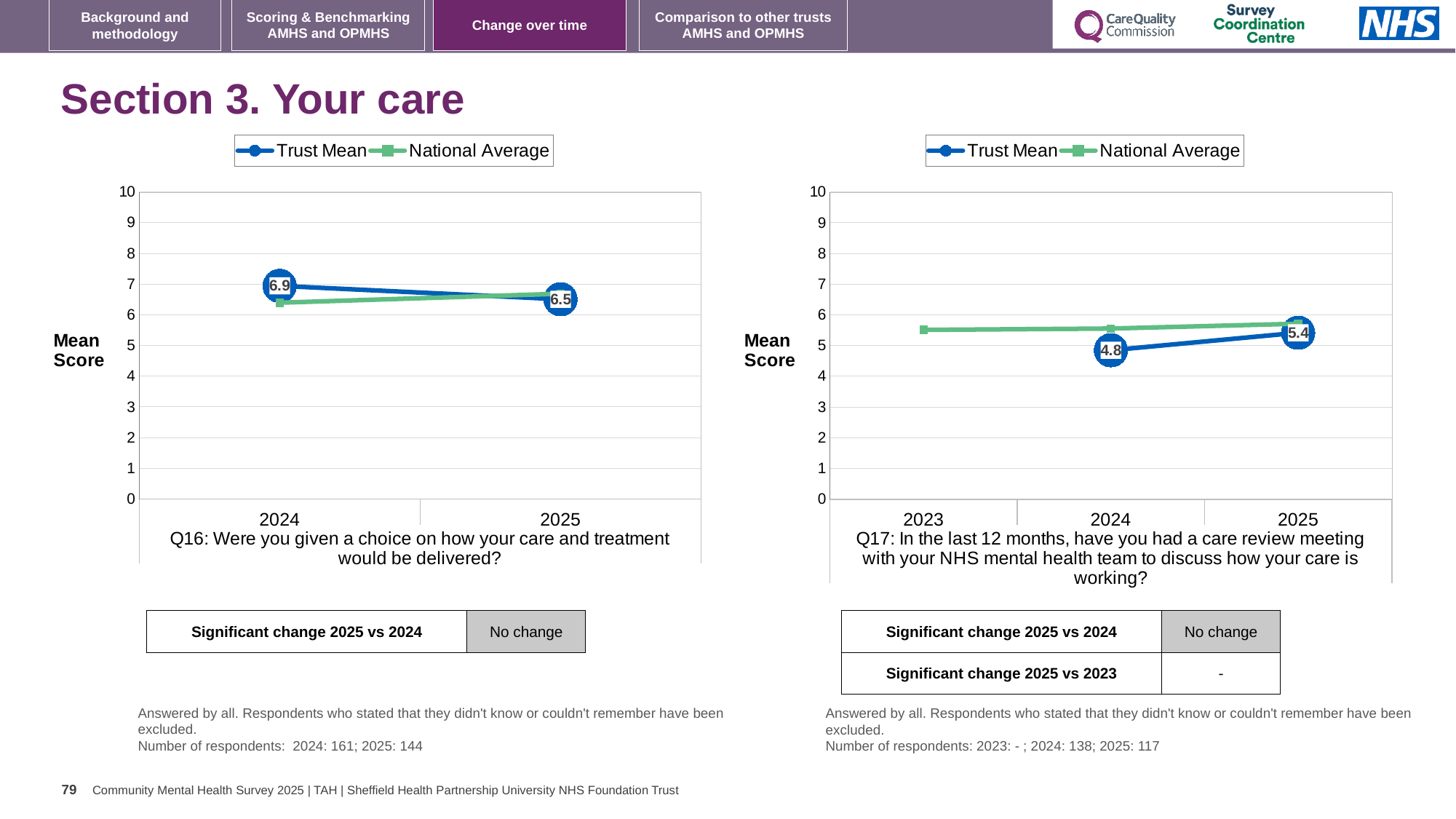
On the Q16 chart (left), by how much did the Trust Mean change from 2024 to 2025? 0.4 On the Q16 chart (left), what is the Trust Mean for 2024? 6.9 On the Q17 chart (right), is the National Average for 2023 greater or less than 5? greater On the Q16 chart (left), what is the Trust Mean for 2025? 6.5 On the Q16 chart (left), does the Trust Mean rise or fall from 2024 to 2025? fall On the Q17 chart (right), what is the Trust Mean for 2024? 4.8 What kind of chart is the Q17 chart (right)? line chart On the Q17 chart (right), what is the difference between the Trust Mean in 2025 and in 2024? 0.6 On the Q17 chart (right), does the Trust Mean rise or fall from 2024 to 2025? rise How many years are shown on the x axis of the Q17 chart (right)? 3 On the Q17 chart (right), what is the Trust Mean for 2025? 5.4 How many series does the legend of the Q16 chart (left) list? 2